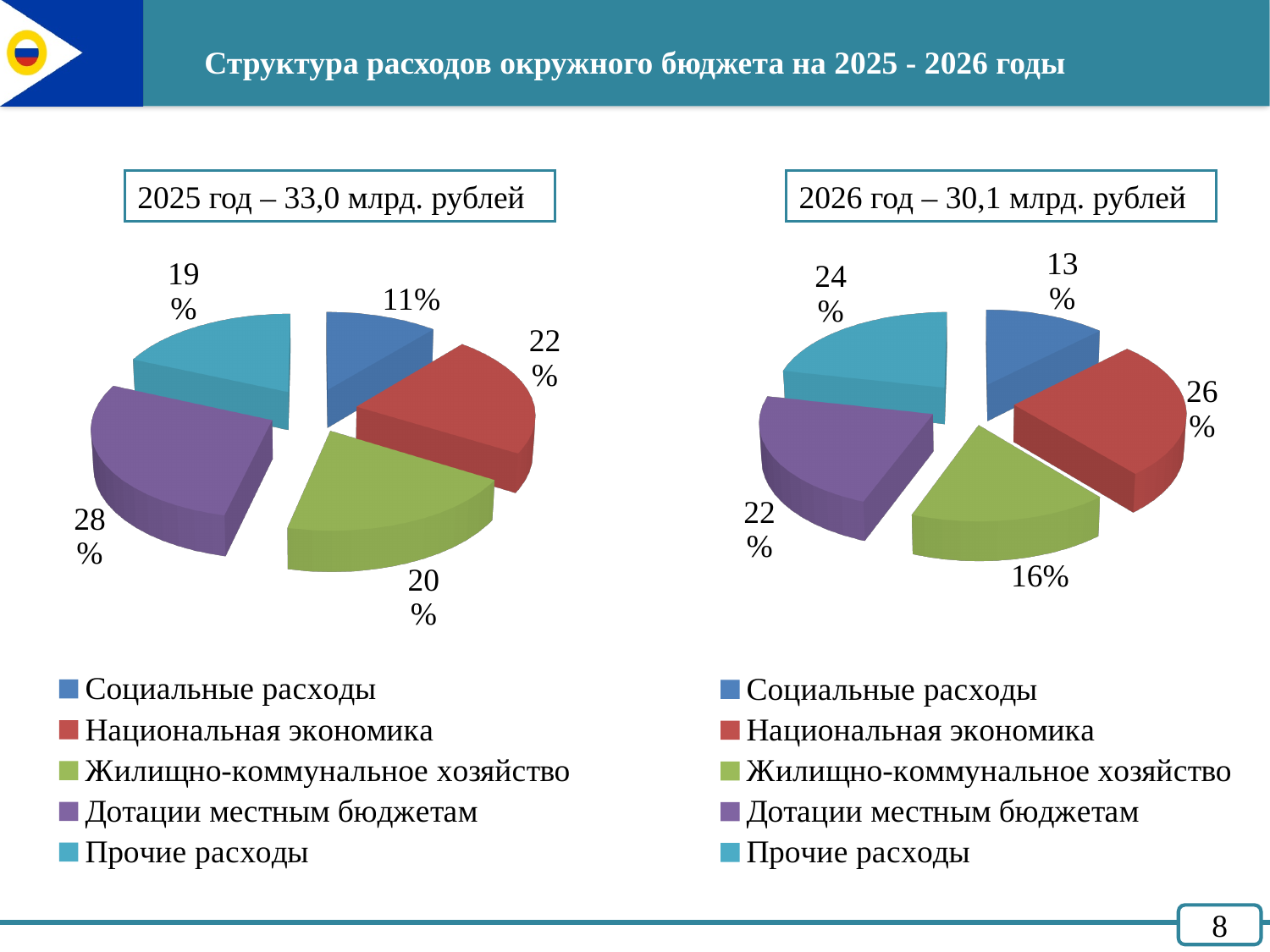
In the 2026 pie chart, what is the difference between the shares of Прочие расходы and Дотации местным бюджетам? 2% In the 2026 pie chart, which category has the smallest share? Социальные расходы How many categories does the legend of the 2025 pie chart list? 5 What type of chart is used on this slide? Pie chart In the 2025 pie chart, which category has the smallest share? Социальные расходы In the 2026 pie chart, which category has the largest share? Национальная экономика In the 2025 pie chart, which is larger: the share of Национальная экономика or the share of Жилищно-коммунальное хозяйство? Национальная экономика In the 2025 pie chart, which category has the largest share? Дотации местным бюджетам In the 2026 pie chart, what share is labelled for Жилищно-коммунальное хозяйство? 16% In the 2026 pie chart, what share is labelled for Национальная экономика? 26% In the 2025 pie chart, what share is labelled for Дотации местным бюджетам? 28% In the 2025 pie chart, what share is labelled for Социальные расходы? 11%